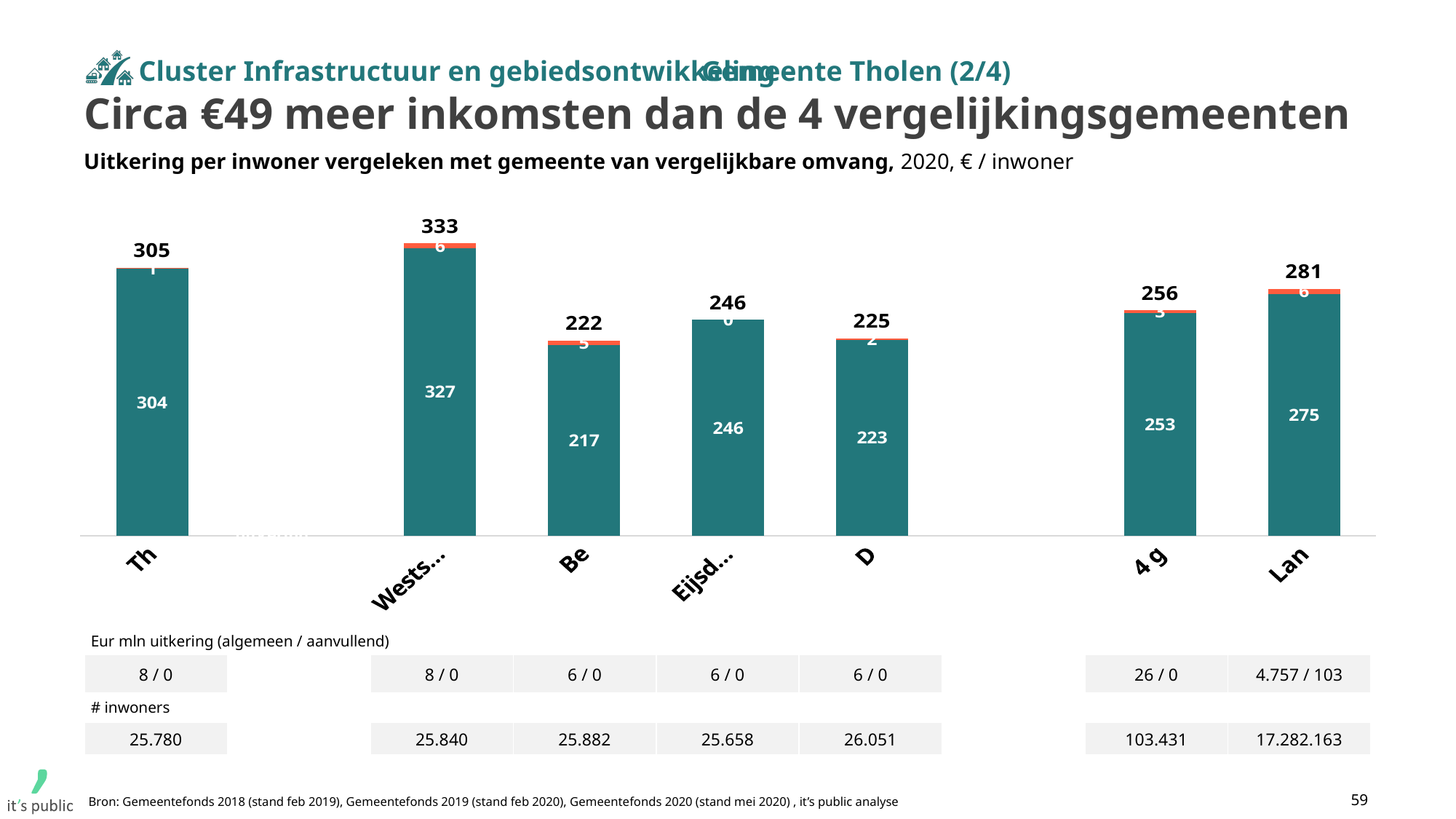
What is the total value shown above the bar for "Lan"? 281 What is the value of the teal (lower) segment of the bar for "Be"? 217 What is the value of the teal (lower) segment of the bar for "4 g"? 253 Which category has the lowest total value? Be What is the difference between the total for "Th" (305) and the total for "4 g" (256)? 49 How many bars are plotted in the chart? 7 What is the total value shown above the bar for "Wests..."? 333 What kind of chart is shown on the slide? Stacked bar chart What unit is stated in the chart subtitle for the plotted values? € / inwoner What is the total value shown above the bar for "Th"? 305 Which category has the highest total value? Wests... Which has a larger total value, "Eijsd..." or "D"? Eijsd...